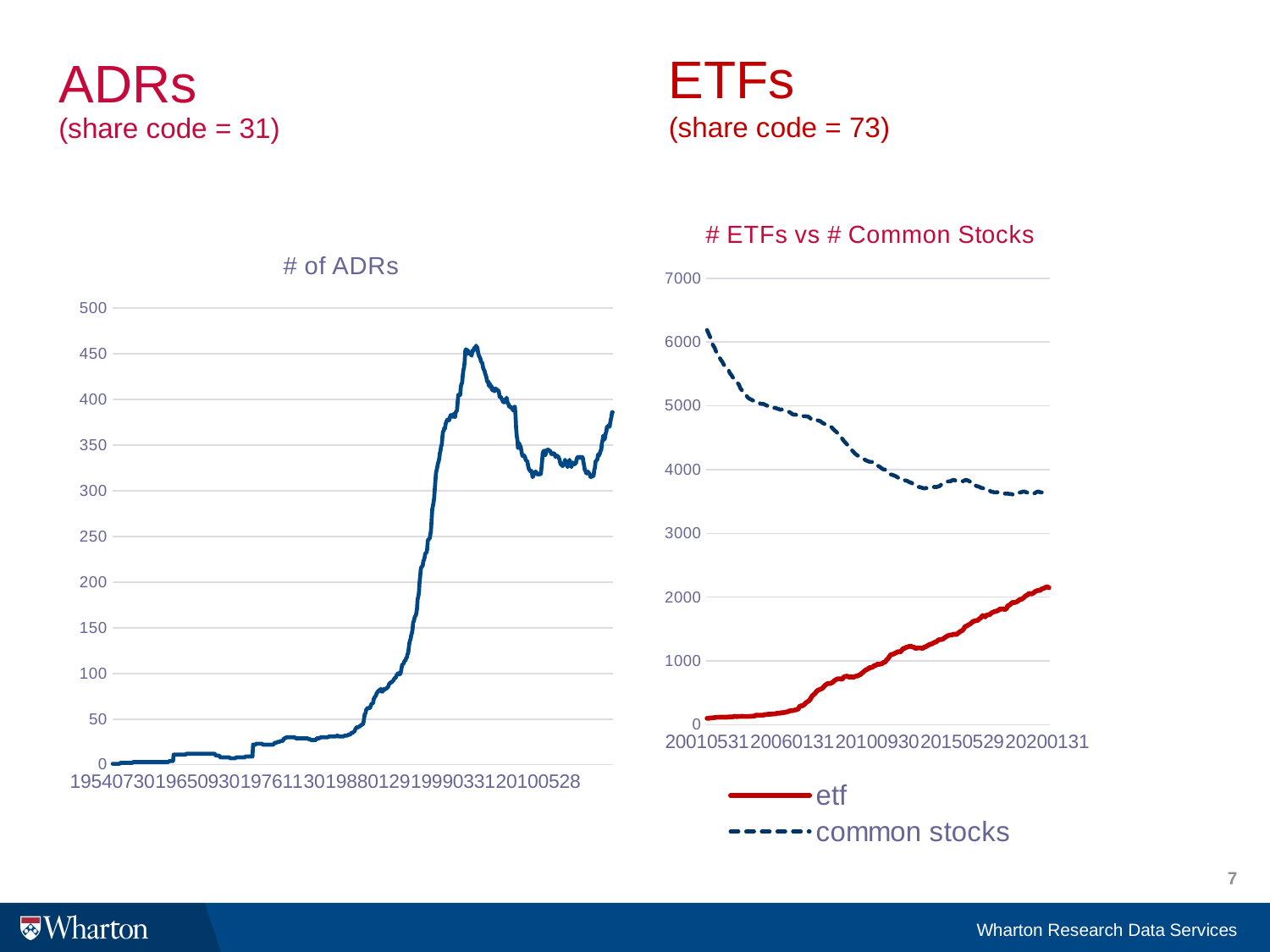
In the '# ETFs vs # Common Stocks' chart, at the end of the series, which is larger: 'etf' or 'common stocks'? common stocks In the '# of ADRs' chart, is the peak value greater or less than 400? greater What kind of chart is the '# of ADRs' chart? line chart In the '# ETFs vs # Common Stocks' chart, does the 'common stocks' series rise or fall overall along the x axis? fall In the '# ETFs vs # Common Stocks' chart, what are the two series named in the legend? etf and common stocks In the '# ETFs vs # Common Stocks' chart, does the 'etf' series rise or fall over time along the x axis? rise In the '# ETFs vs # Common Stocks' chart, how many series does the legend list? 2 What kind of chart is the '# ETFs vs # Common Stocks' chart? line chart What is the title of the chart on the right side of the slide? # ETFs vs # Common Stocks In the '# ETFs vs # Common Stocks' chart, is the value of 'common stocks' at the start of the series (around 20010531) greater or less than 5000? greater In the '# ETFs vs # Common Stocks' chart, is the value of 'etf' at the end of the series (around 20200131) greater or less than 3000? less